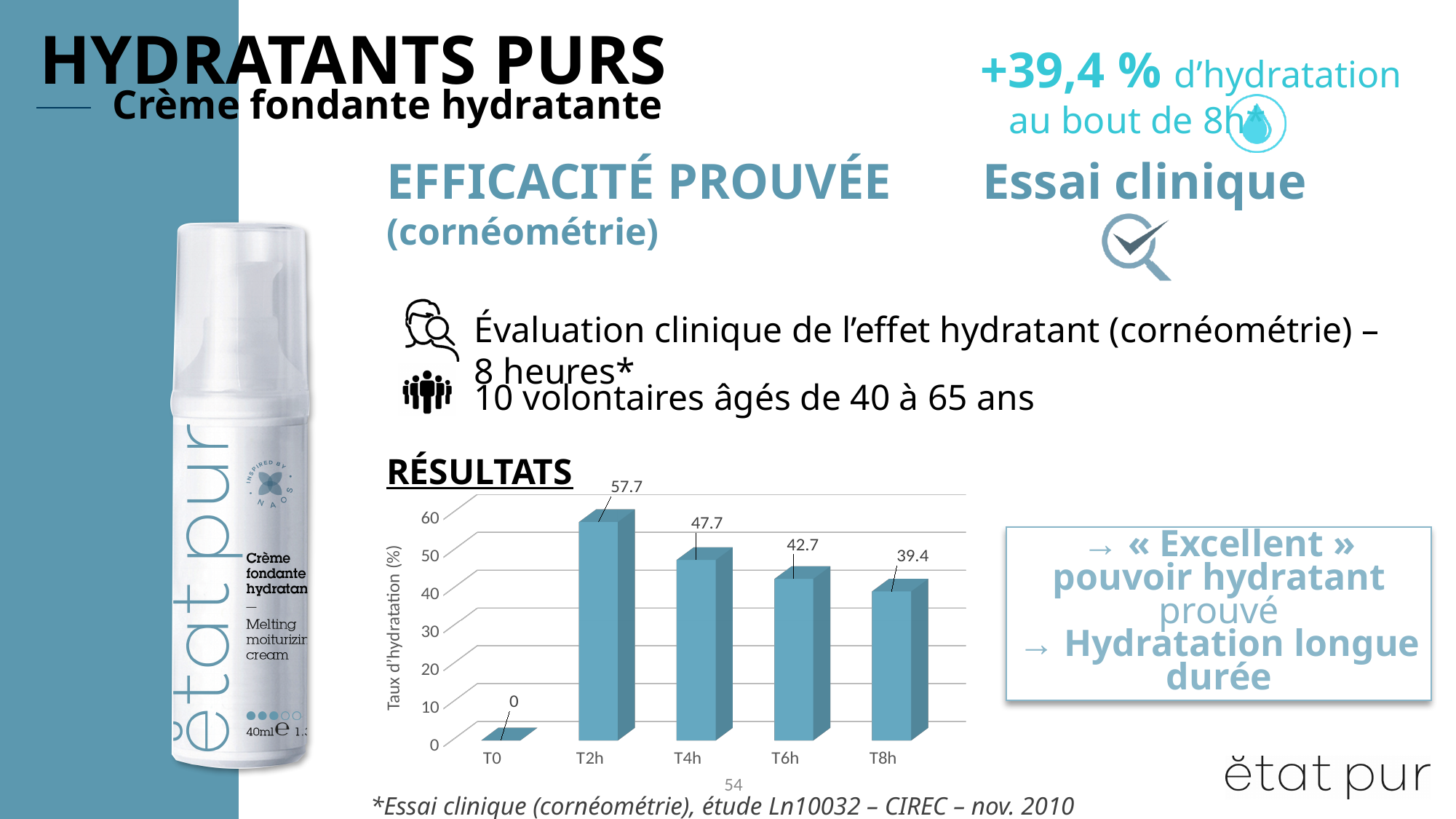
What is the label of the vertical axis? Taux d'hydratation (%) Is the value at T6h greater or less than 40? greater What kind of chart is shown under RÉSULTATS? bar chart What is the hydration rate value at T8h? 39.4 What is the hydration rate value at T0? 0 Which time point has the highest hydration rate? T2h What is the hydration rate value at T2h? 57.7 Which time point has the lowest hydration rate? T0 How many time points are shown on the x axis? 5 Which is larger, the value at T4h or the value at T6h? T4h What is the difference between the values at T2h and T8h? 18.3 What is the hydration rate value at T4h? 47.7